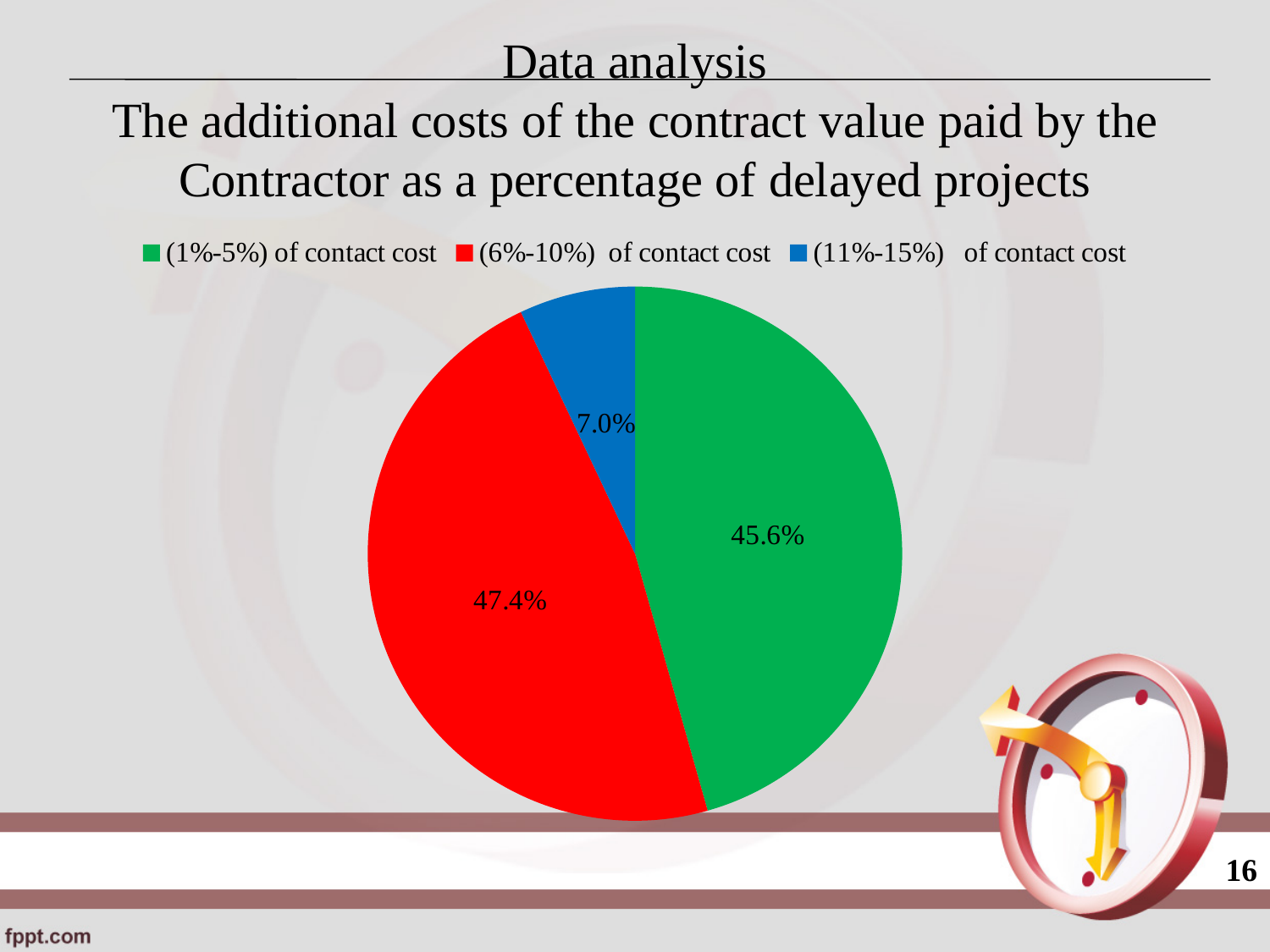
What percentage is shown for the (11%-15%) of contact cost slice? 7.0% What percentage is shown for the (1%-5%) of contact cost slice? 45.6% Which is larger, the (1%-5%) of contact cost slice or the (11%-15%) of contact cost slice? (1%-5%) of contact cost What colour is the (11%-15%) of contact cost slice? blue What percentage is shown for the (6%-10%) of contact cost slice? 47.4% What kind of chart is shown on the slide? pie chart What is the difference in percentage points between the (1%-5%) slice and the (11%-15%) slice? 38.6 Which slice of the pie chart has the smallest share? (11%-15%) of contact cost What is the difference in percentage points between the (6%-10%) slice and the (1%-5%) slice? 1.8 Which slice of the pie chart has the largest share? (6%-10%) of contact cost How many slices does the pie chart have? 3 How many entries does the legend list? 3